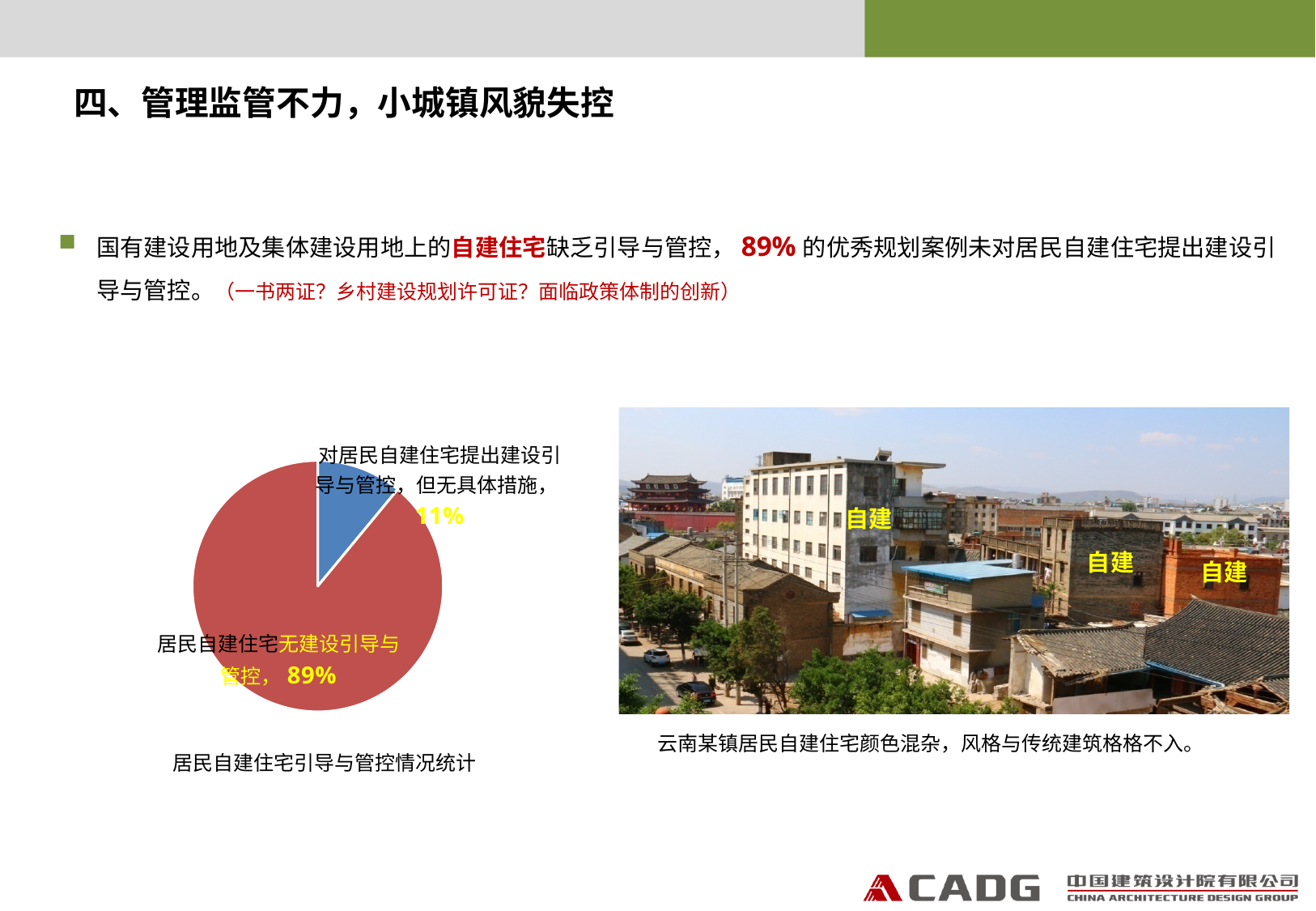
How many slices does the pie chart have? 2 What share of the pie is labelled 对居民自建住宅提出建设引导与管控，但无具体措施? 11% What is the title of the chart on the slide? 居民自建住宅引导与管控情况统计 What share of the pie is labelled 居民自建住宅无建设引导与管控? 89% Is the share for 对居民自建住宅提出建设引导与管控，但无具体措施 greater or less than 50%? less What colour is the slice representing 89% in the pie chart? red Which is larger: the share for 居民自建住宅无建设引导与管控 or the share for 对居民自建住宅提出建设引导与管控，但无具体措施? 居民自建住宅无建设引导与管控 Which slice of the pie chart is the smallest? 对居民自建住宅提出建设引导与管控，但无具体措施 What kind of chart is shown on the slide? pie chart What is the difference in percentage points between the 89% slice and the 11% slice? 78 Which slice of the pie chart is the largest? 居民自建住宅无建设引导与管控